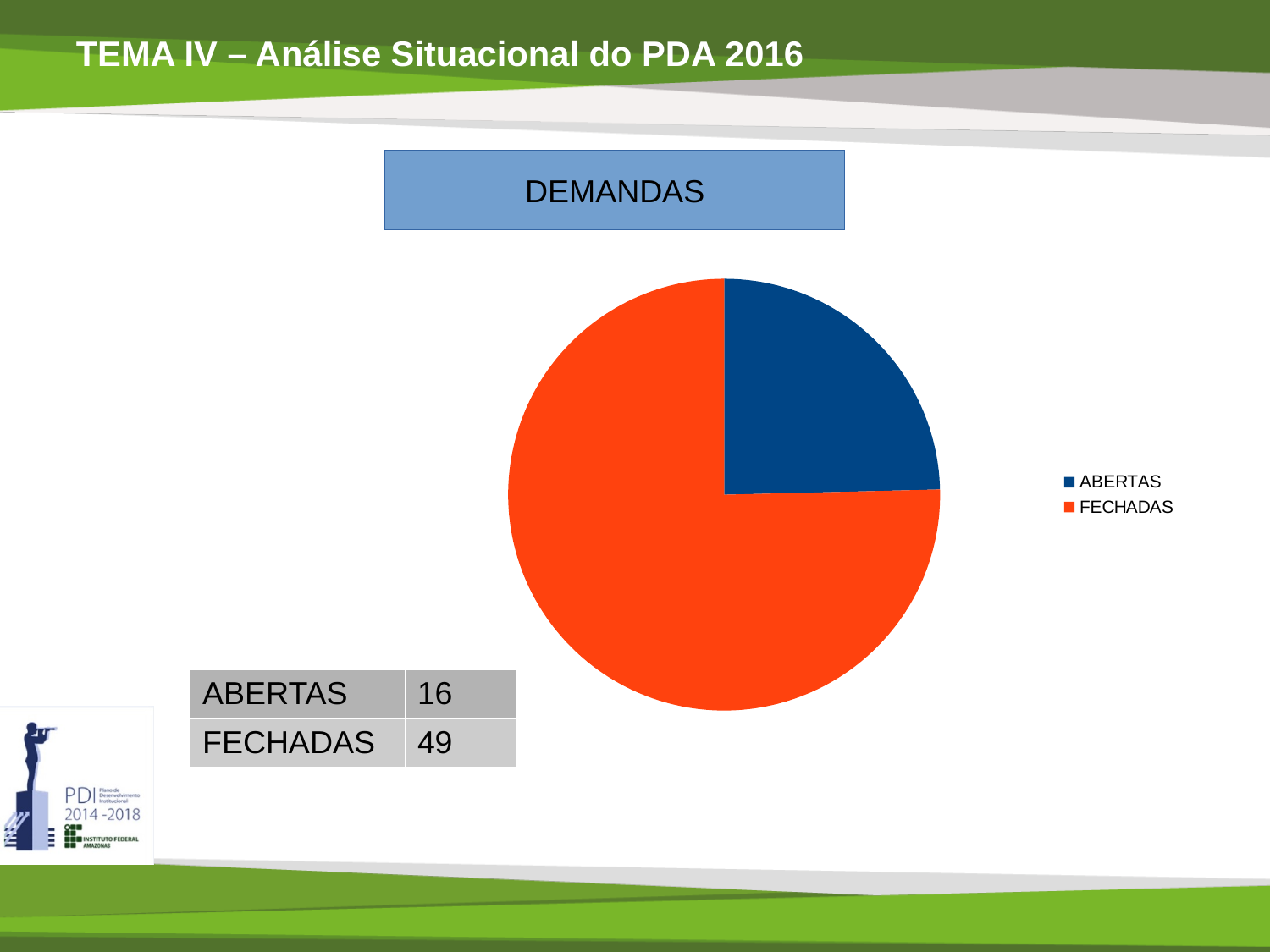
What is the value for ABERTAS? 16 Which category has the largest slice of the pie chart? FECHADAS Which category has the smallest slice of the pie chart? ABERTAS How many series does the legend of the pie chart list? 2 What colour represents FECHADAS in the pie chart? orange What is the total of ABERTAS and FECHADAS combined? 65 Which is larger, ABERTAS or FECHADAS? FECHADAS What is the difference between the values for FECHADAS and ABERTAS? 33 What is the value for FECHADAS? 49 How many slices does the pie chart have? 2 What type of chart is shown on the slide? pie chart What is the title shown above the pie chart? DEMANDAS